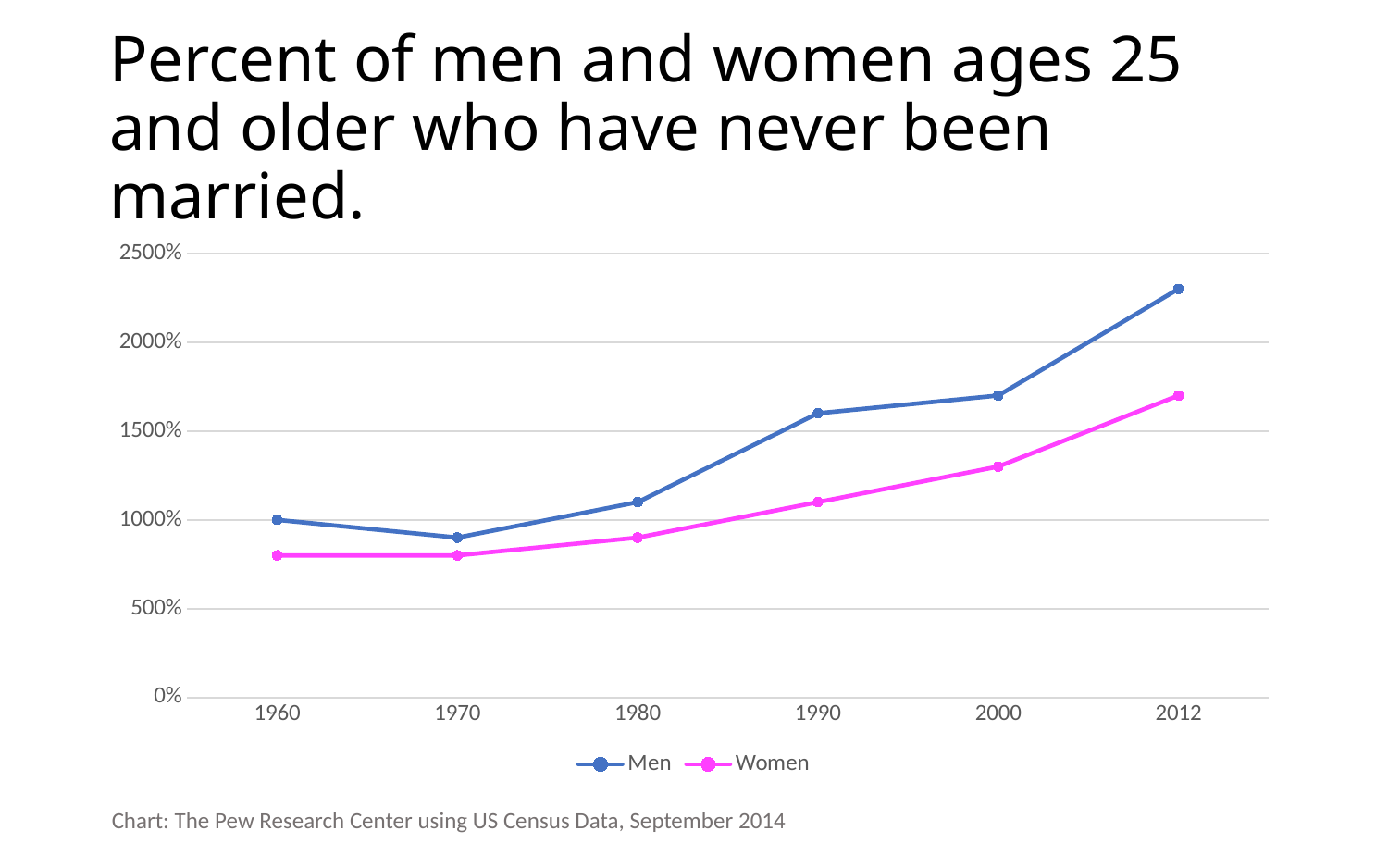
In which year is the value for Men highest? 2012 Do the values for Women rise or fall from 1980 to 2012? rise Is the value for Women in 1960 greater or less than 1000%? less Is the value for Men in 1990 greater or less than 1500%? greater What kind of chart is shown on the slide? line chart How many series does the legend list? 2 What is the value for Men in 1960? 1000% How many years are plotted along the x axis? 6 Which series has the larger value in 2000, Men or Women? Men Is the value for Men in 2012 greater or less than 2000%? greater In which year is the value for Men lowest? 1970